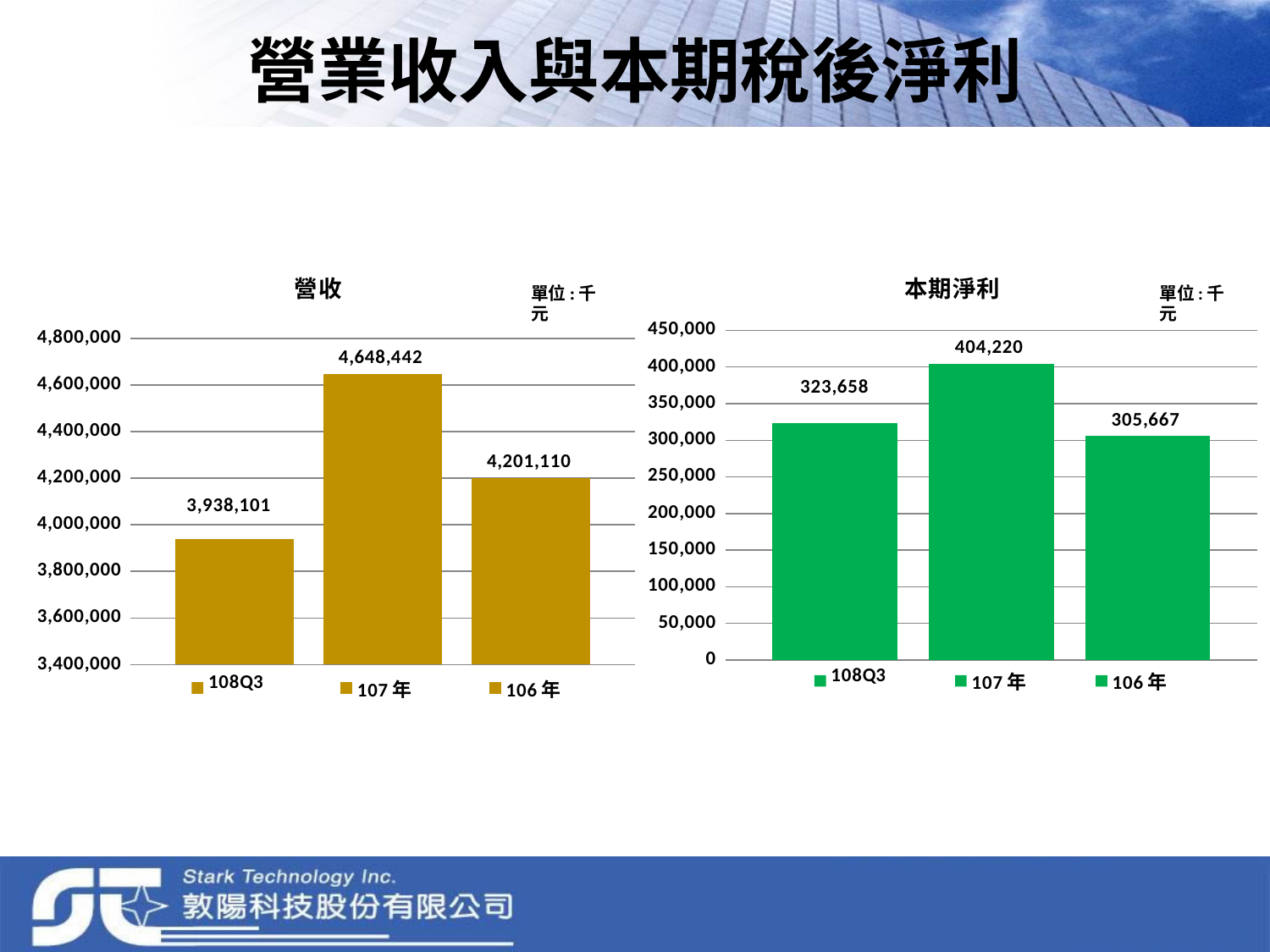
In the 營收 chart, what is the value for 107 年? 4,648,442 In the 營收 chart, which category has the highest value? 107 年 In the 營收 chart, what is the difference between the values for 107 年 and 108Q3? 710,341 In the 本期淨利 chart, what is the value for 108Q3? 323,658 What unit is stated next to the 營收 chart title? 千元 In the 本期淨利 chart, which is larger, the value for 108Q3 or the value for 106 年? 108Q3 In the 本期淨利 chart, what is the value for 106 年? 305,667 What kind of chart is the 本期淨利 chart? Bar chart In the 營收 chart, what is the value for 108Q3? 3,938,101 In the 本期淨利 chart, what is the difference between the values for 107 年 and 108Q3? 80,562 In the 本期淨利 chart, which category has the lowest value? 106 年 In the 營收 chart, how many bars are plotted? 3